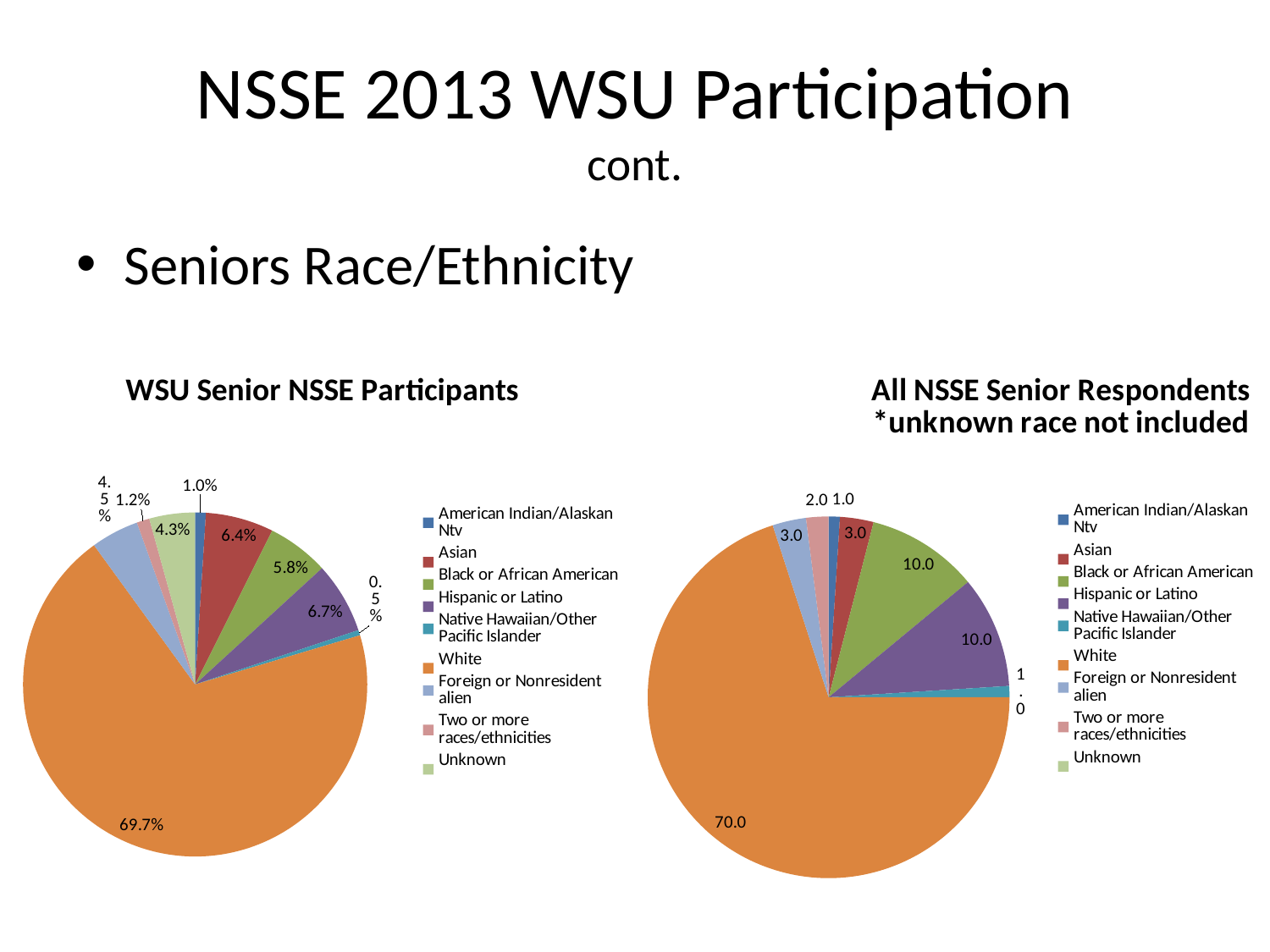
In the All NSSE Senior Respondents pie chart, what is the value for White? 70.0 In the WSU Senior NSSE Participants pie chart, what is the value for Hispanic or Latino? 6.7% In the All NSSE Senior Respondents pie chart, what is the difference between the values for White and Hispanic or Latino? 60.0 In the All NSSE Senior Respondents pie chart, what is the value for Black or African American? 10.0 In the All NSSE Senior Respondents pie chart, what is the value for Two or more races/ethnicities? 2.0 In the WSU Senior NSSE Participants pie chart, which is larger: Asian or Black or African American? Asian In the WSU Senior NSSE Participants pie chart, what is the value for Asian? 6.4% What kind of chart is the WSU Senior NSSE Participants chart? Pie chart In the WSU Senior NSSE Participants pie chart, which category has the smallest share? Native Hawaiian/Other Pacific Islander How many entries does the legend of the All NSSE Senior Respondents chart list? 9 In the WSU Senior NSSE Participants pie chart, which category has the largest share? White In the WSU Senior NSSE Participants pie chart, what is the value for White? 69.7%